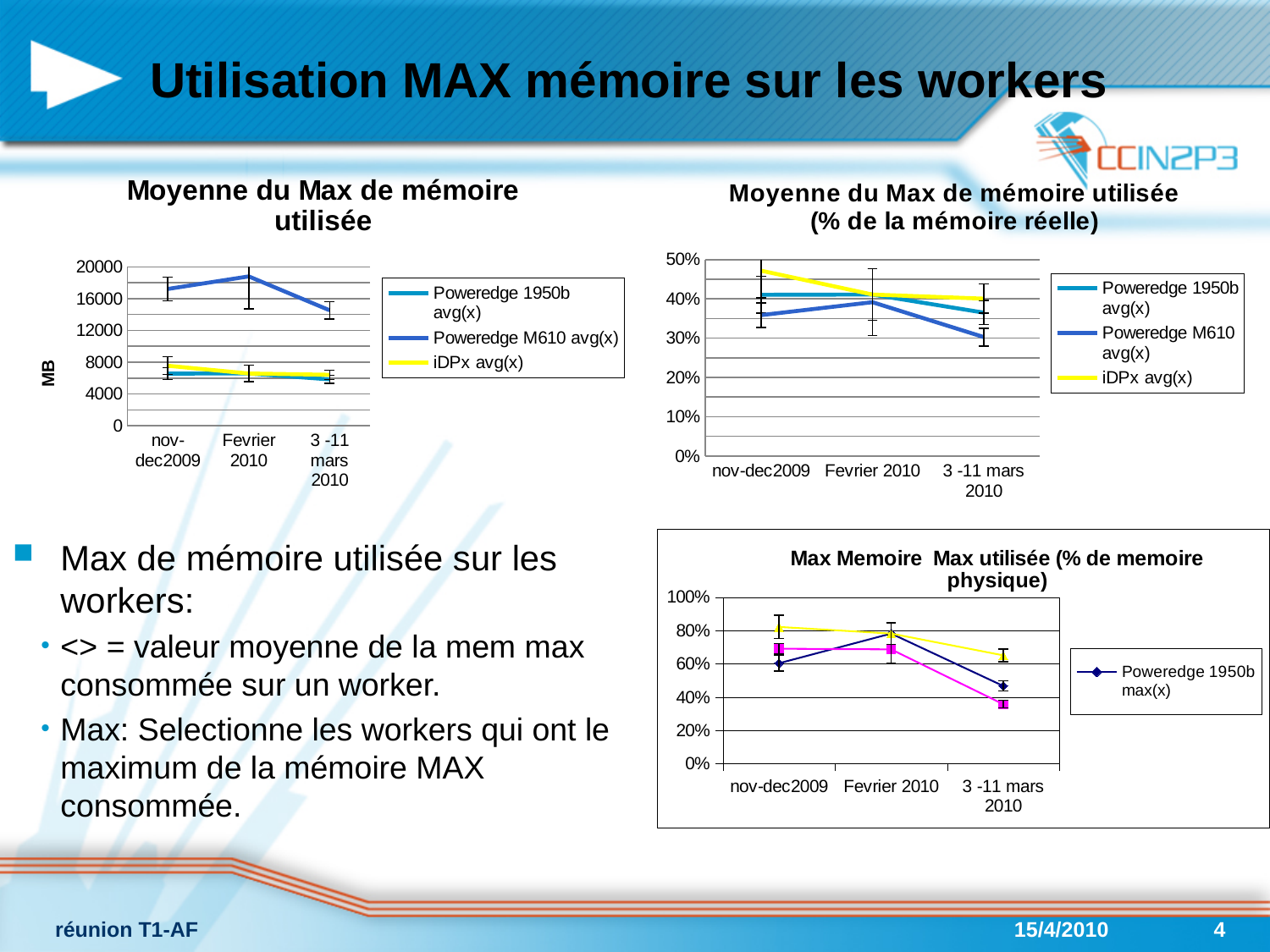
In the top-left chart 'Moyenne du Max de mémoire utilisée', how many time periods are shown on the x axis? 3 In the bottom-right chart 'Max Memoire Max utilisée (% de memoire physique)', is the value for Poweredge 1950b max(x) at Fevrier 2010 greater or less than 60%? greater In the bottom-right chart 'Max Memoire Max utilisée (% de memoire physique)', how many series does the legend list? 1 In the top-right chart 'Moyenne du Max de mémoire utilisée (% de la mémoire réelle)', which series has the lowest value at 3-11 mars 2010? Poweredge M610 avg(x) What kind of chart is the top-left chart titled 'Moyenne du Max de mémoire utilisée'? Line chart In the top-left chart 'Moyenne du Max de mémoire utilisée', is the value for Poweredge M610 avg(x) at Fevrier 2010 greater or less than 16000? greater In the top-left chart 'Moyenne du Max de mémoire utilisée', is the value for Poweredge 1950b avg(x) at 3-11 mars 2010 greater or less than 8000? less In the top-left chart 'Moyenne du Max de mémoire utilisée', which series has the highest value at Fevrier 2010? Poweredge M610 avg(x) In the top-left chart 'Moyenne du Max de mémoire utilisée', does the Poweredge M610 avg(x) line rise or fall from Fevrier 2010 to 3-11 mars 2010? fall In the top-right chart 'Moyenne du Max de mémoire utilisée (% de la mémoire réelle)', which series has the highest value at nov-dec2009? iDPx avg(x) In the top-left chart 'Moyenne du Max de mémoire utilisée', how many series does the legend list? 3